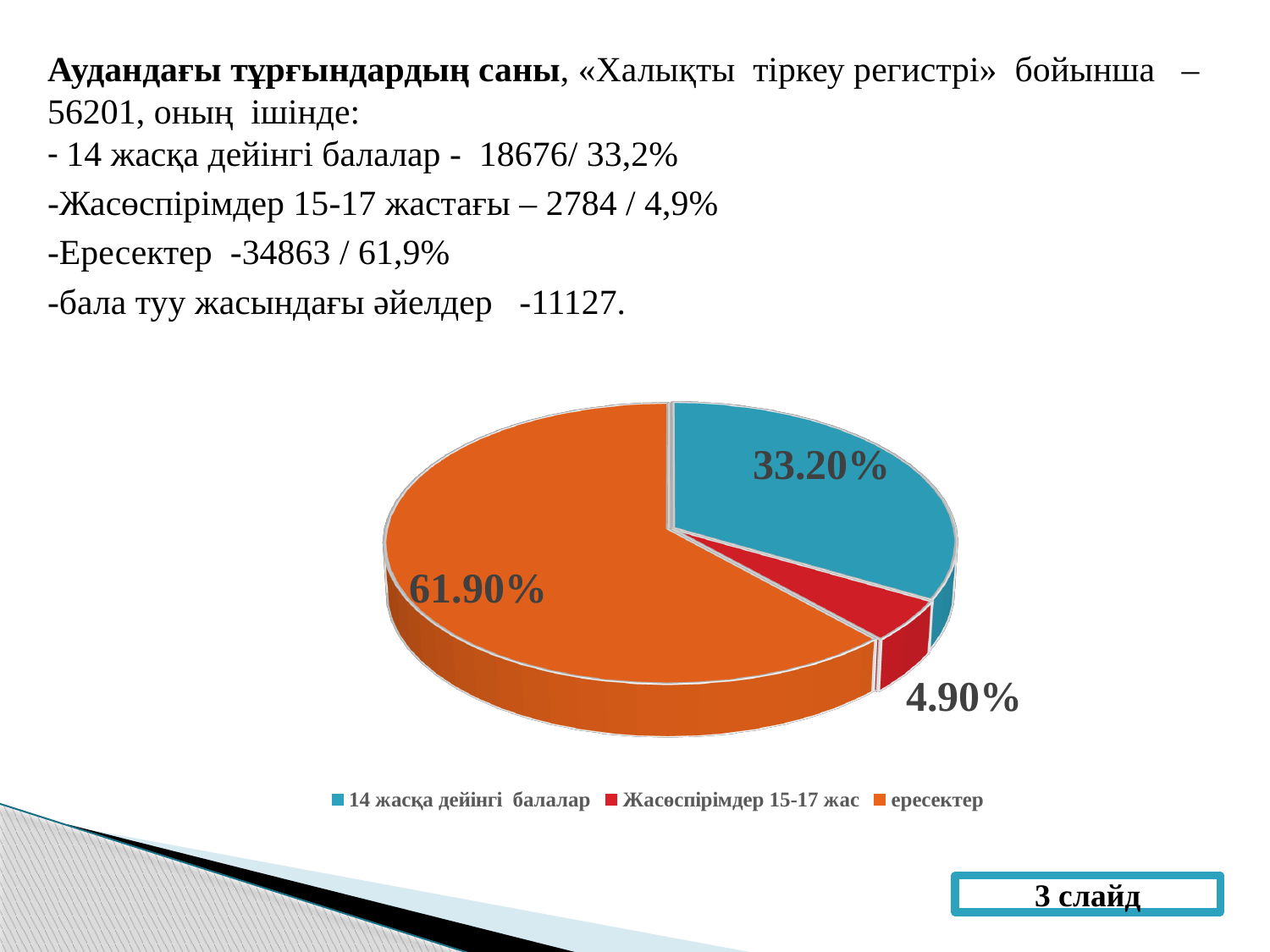
How many slices does the pie chart have? 3 What colour is the slice for "ересектер"? orange What share of the pie does the slice for "Жасөспірімдер 15-17 жас" represent? 4.90% What colour is the slice for "Жасөспірімдер 15-17 жас"? red Which is larger: the slice for "14 жасқа дейінгі балалар" or the slice for "Жасөспірімдер 15-17 жас"? 14 жасқа дейінгі балалар Which category has the smallest slice of the pie? Жасөспірімдер 15-17 жас What kind of chart is shown on the slide? pie chart What share of the pie does the slice for "ересектер" represent? 61.90% What share of the pie does the slice for "14 жасқа дейінгі балалар" represent? 33.20% What is the difference in percentage points between the "ересектер" slice and the "14 жасқа дейінгі балалар" slice? 28.70% Which category has the largest slice of the pie? ересектер How many entries does the legend list? 3